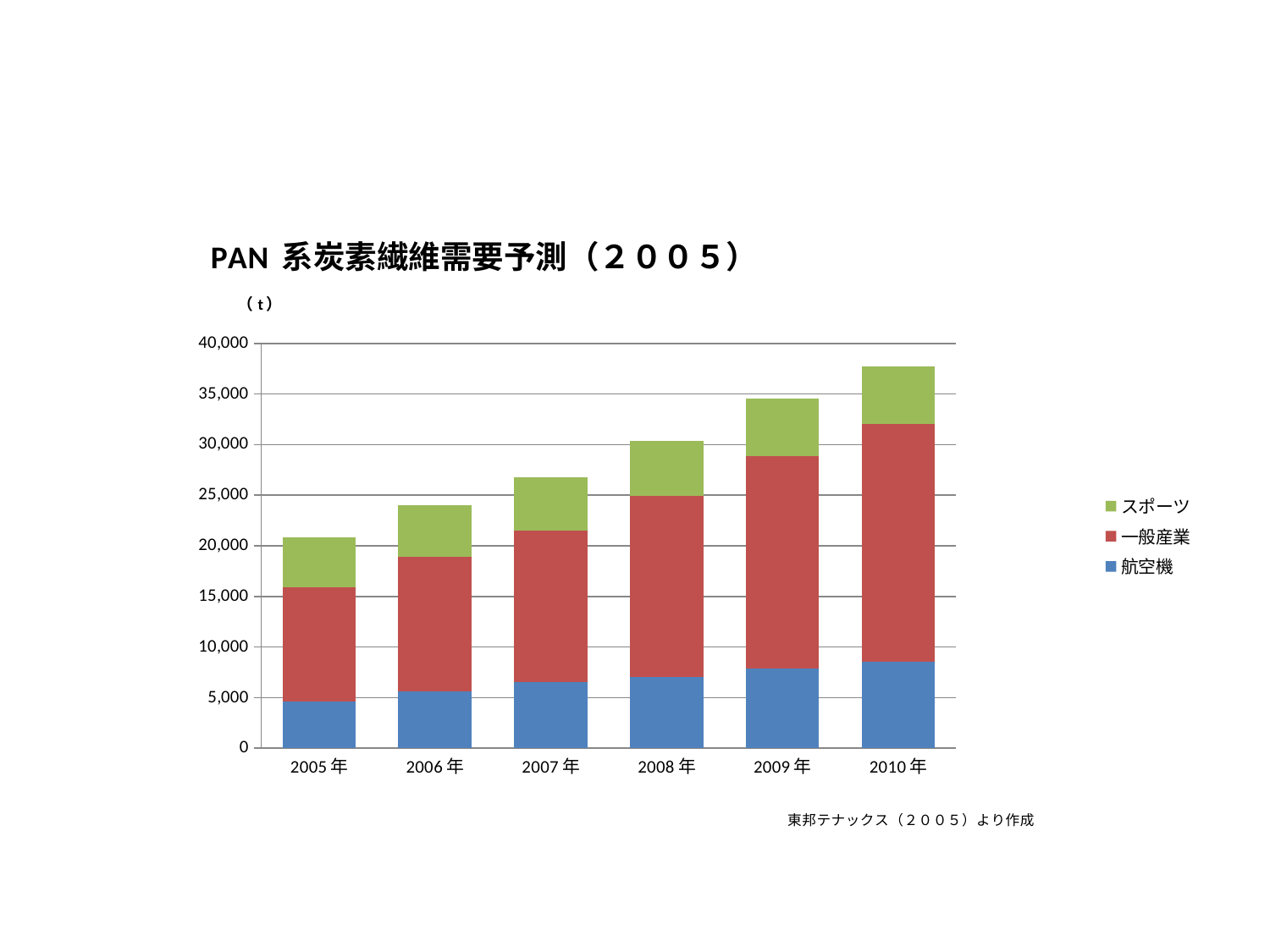
What is the title of the chart? PAN 系炭素繊維需要予測（２００５） Which year has the lowest total bar in the chart? 2005年 Is the total bar for 2010年 greater or less than 35,000? greater How many series does the chart's legend list? 3 Is the total bar for 2005年 greater or less than 20,000? greater What kind of chart is shown on the slide? stacked bar chart Is the total bar for 2006年 greater or less than 25,000? less How many years are shown on the x axis of the chart? 6 Which year has the highest total bar in the chart? 2010年 Do the total bar heights rise or fall from 2005年 to 2010年? rise Is the total bar for 2010年 larger than the total bar for 2009年? yes